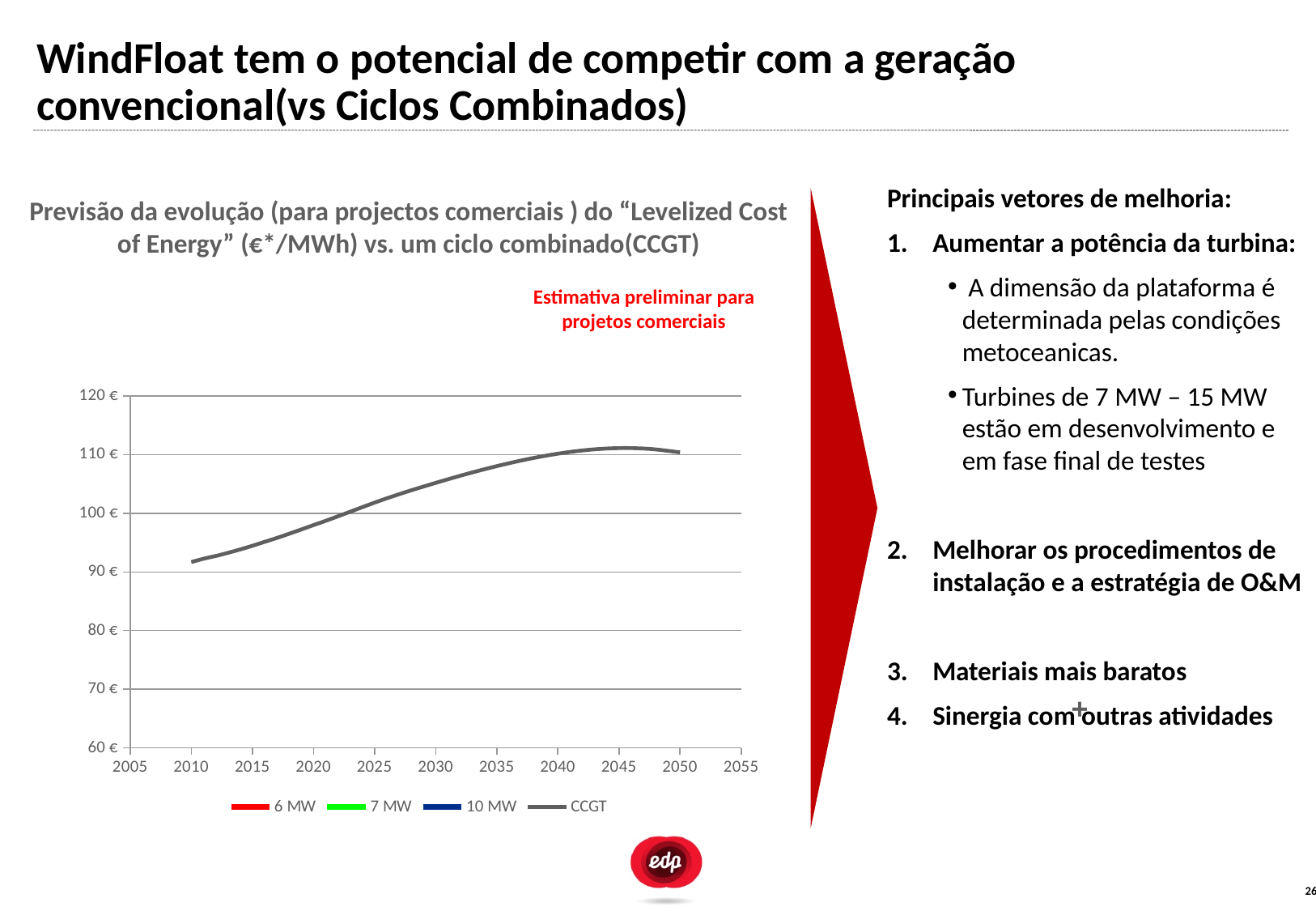
Which legend series is the only one actually plotted as a line on the chart? CCGT Is the CCGT value in 2050 greater or less than 120 €? less Is the CCGT value in 2010 greater or less than 100 €? less Which is larger for CCGT: the value in 2010 or the value in 2045? 2045 Is the CCGT value in 2020 greater or less than 100 €? less Does the CCGT line rise or fall between 2010 and 2040? rises How many series does the chart legend list? 4 How many year labels are shown on the x axis? 11 What kind of chart is shown on the slide? line chart What colour is the CCGT line in the chart? grey